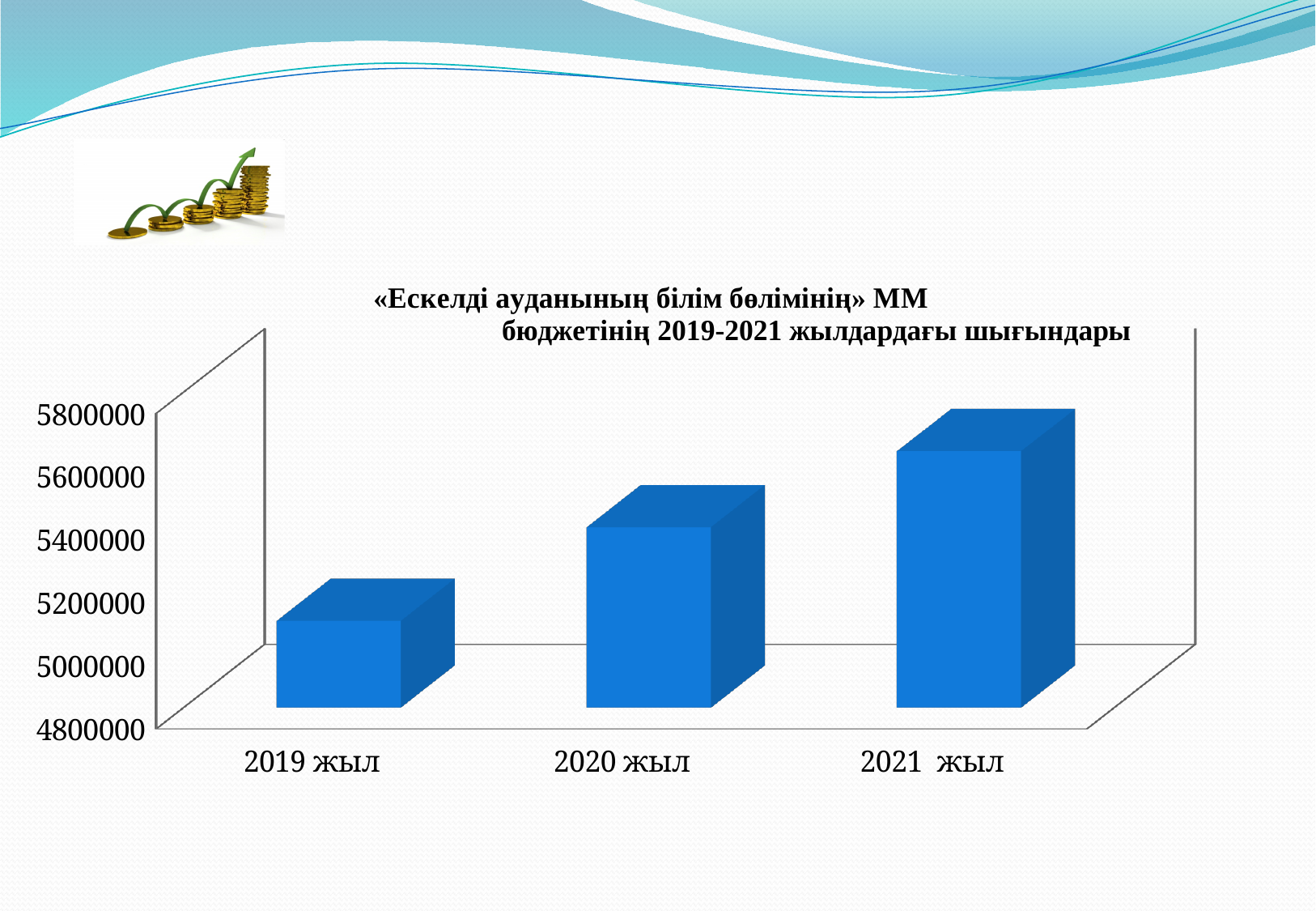
Which year has the highest bar? 2021 жыл Do the values rise or fall from 2019 жыл to 2021 жыл? rise Which is larger, the value for 2020 жыл or the value for 2019 жыл? 2020 жыл Which year has the lowest bar? 2019 жыл Is the value for 2021 жыл greater or less than 5400000? greater Which is larger, the value for 2021 жыл or the value for 2020 жыл? 2021 жыл What is the lowest value shown on the vertical axis of the chart? 4800000 Is the value for 2019 жыл greater or less than 5000000? greater Is the value for 2020 жыл greater or less than 5200000? greater What kind of chart is shown on the slide? bar chart How many categories (years) are plotted on the chart? 3